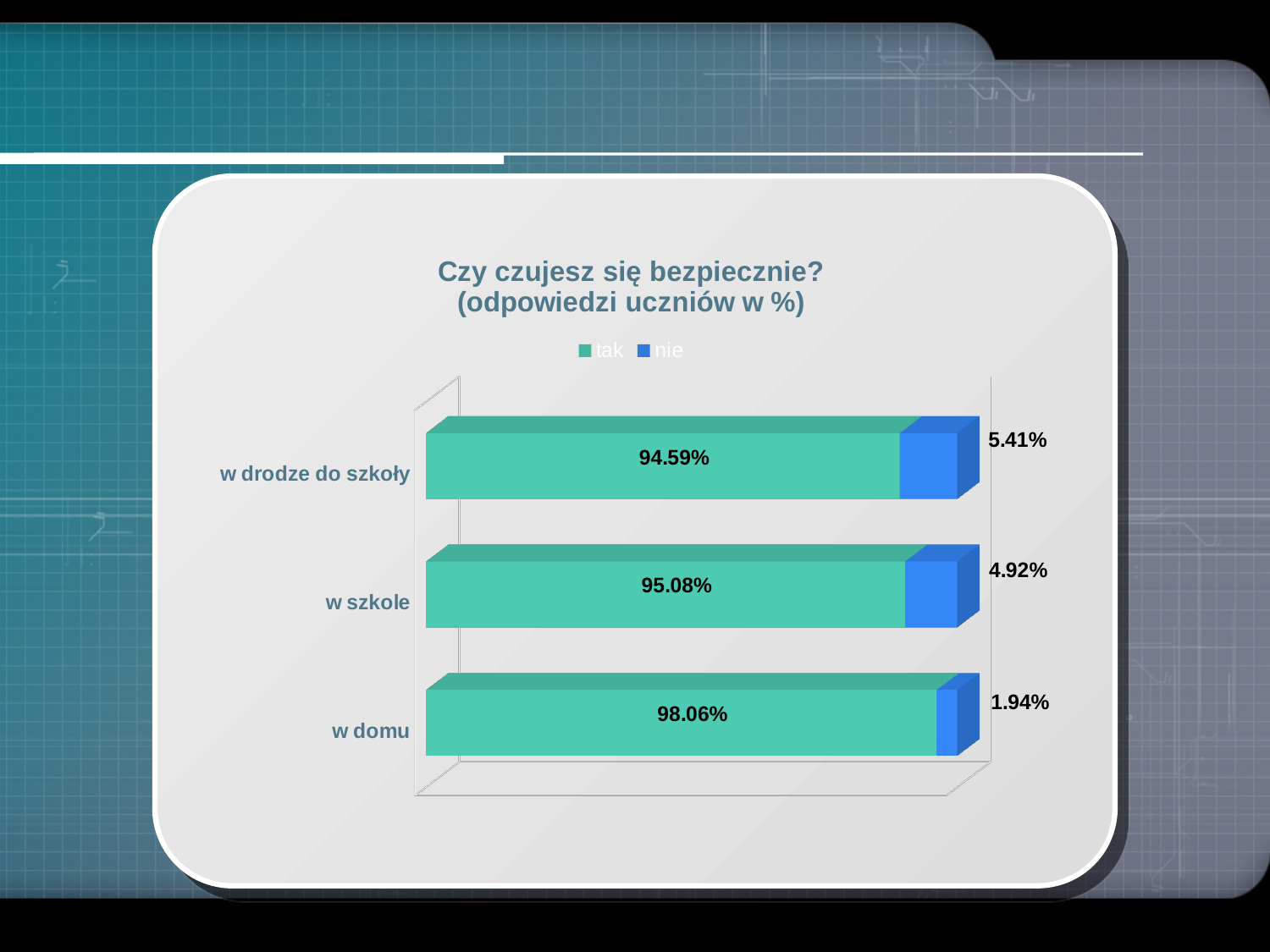
How many categories are shown in the chart? 3 What is the 'tak' value for 'w domu'? 98.06% Which category has the lowest 'nie' value? w domu Which category has the highest 'nie' value? w drodze do szkoły What is the difference between the 'tak' values for 'w domu' and 'w drodze do szkoły'? 3.47% Which category has the highest 'tak' value? w domu What is the 'nie' value for 'w drodze do szkoły'? 5.41% Which is larger: the 'nie' value for 'w szkole' or for 'w drodze do szkoły'? w drodze do szkoły How many series does the legend list? 2 What type of chart is shown on the slide? Stacked bar chart What is the 'nie' value for 'w domu'? 1.94% What is the 'tak' value for 'w szkole'? 95.08%